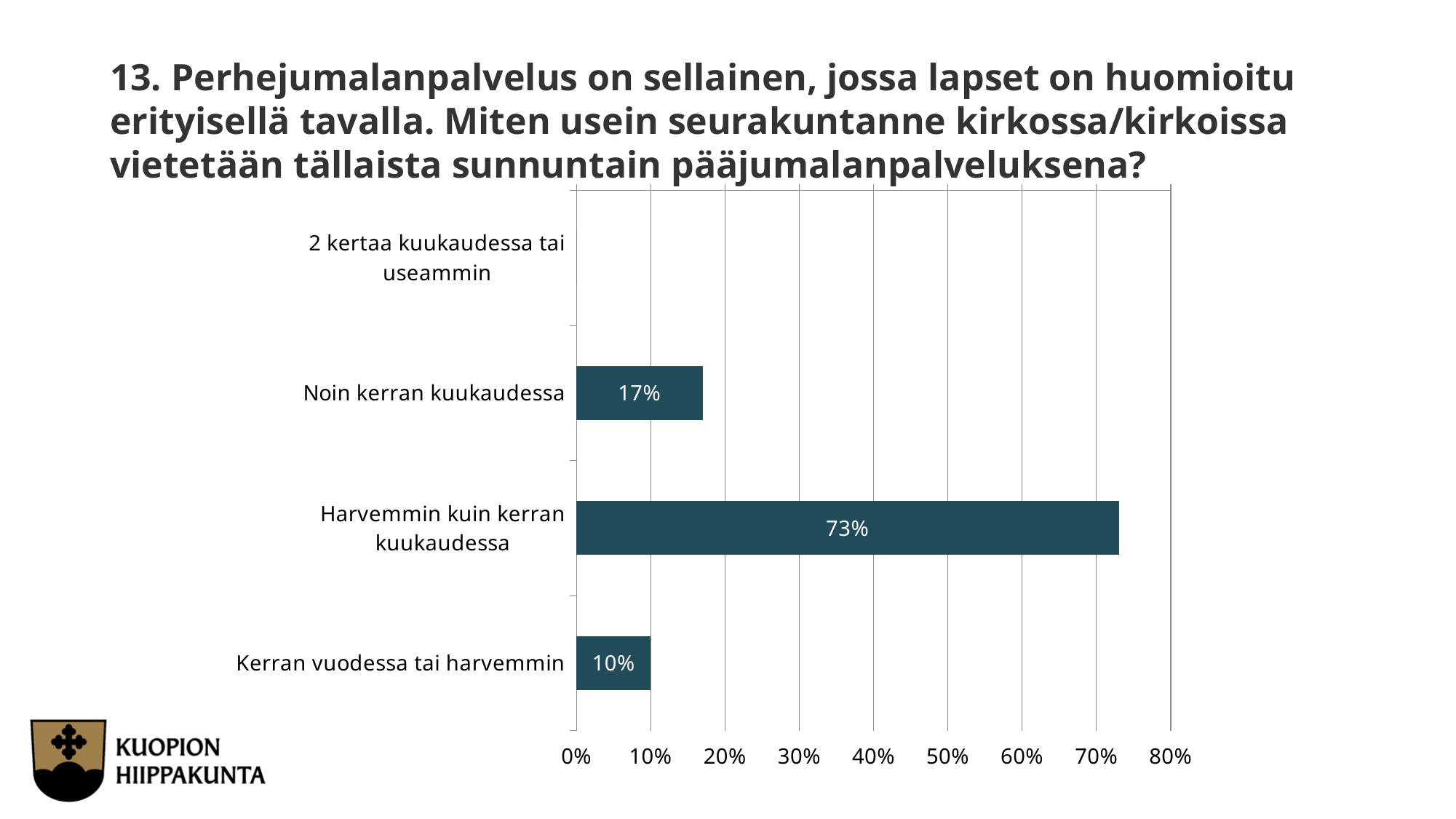
What kind of chart is shown on the slide? Bar chart What is the maximum value shown on the horizontal axis of the chart? 80% What is the value for "Harvemmin kuin kerran kuukaudessa"? 73% Which of the categories with a labelled bar has the lowest value? Kerran vuodessa tai harvemmin What is the value for "Kerran vuodessa tai harvemmin"? 10% Is the value for "Harvemmin kuin kerran kuukaudessa" greater or less than 70%? greater What is the value for "Noin kerran kuukaudessa"? 17% How many categories are listed on the vertical axis of the chart? 4 Which category has the highest value? Harvemmin kuin kerran kuukaudessa What is the difference between the values for "Noin kerran kuukaudessa" and "Kerran vuodessa tai harvemmin"? 7% What is the difference between the values for "Harvemmin kuin kerran kuukaudessa" and "Noin kerran kuukaudessa"? 56% Which is larger, the value for "Noin kerran kuukaudessa" or the value for "Kerran vuodessa tai harvemmin"? Noin kerran kuukaudessa